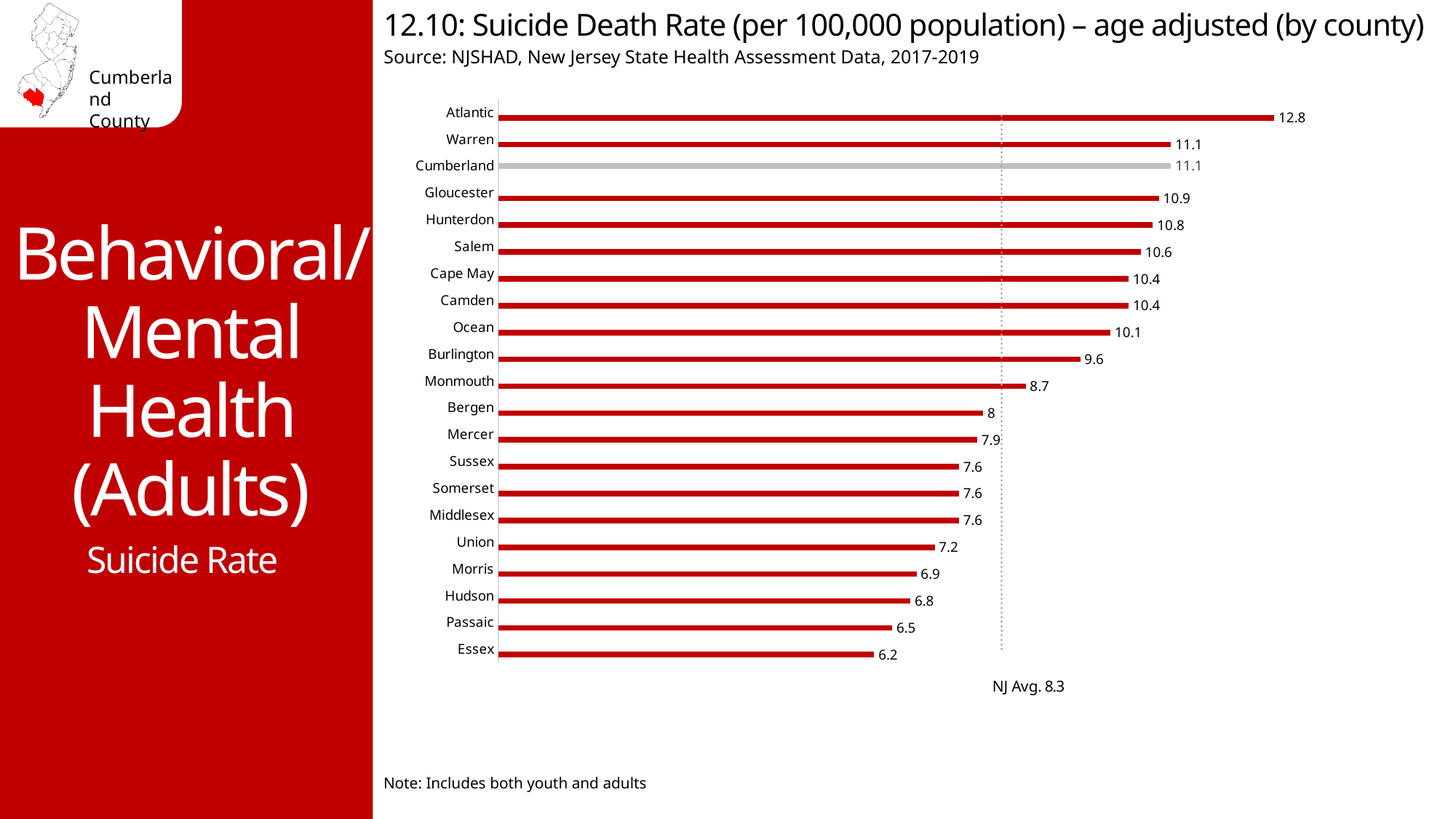
Which county has the highest suicide death rate? Atlantic What is the NJ average suicide death rate shown on the chart? 8.3 What is the suicide death rate for Atlantic County? 12.8 How many counties are shown in the chart? 21 What is the difference between Cumberland County's suicide death rate and the NJ average? 2.8 Which county has a higher suicide death rate, Gloucester or Bergen? Gloucester What type of chart is used on this slide? Bar chart Which county has the lowest suicide death rate? Essex Which county's bar is shown in gray instead of red? Cumberland What is the difference between the suicide death rates of Atlantic and Essex counties? 6.6 What is the suicide death rate for Cumberland County? 11.1 What is the suicide death rate for Essex County? 6.2